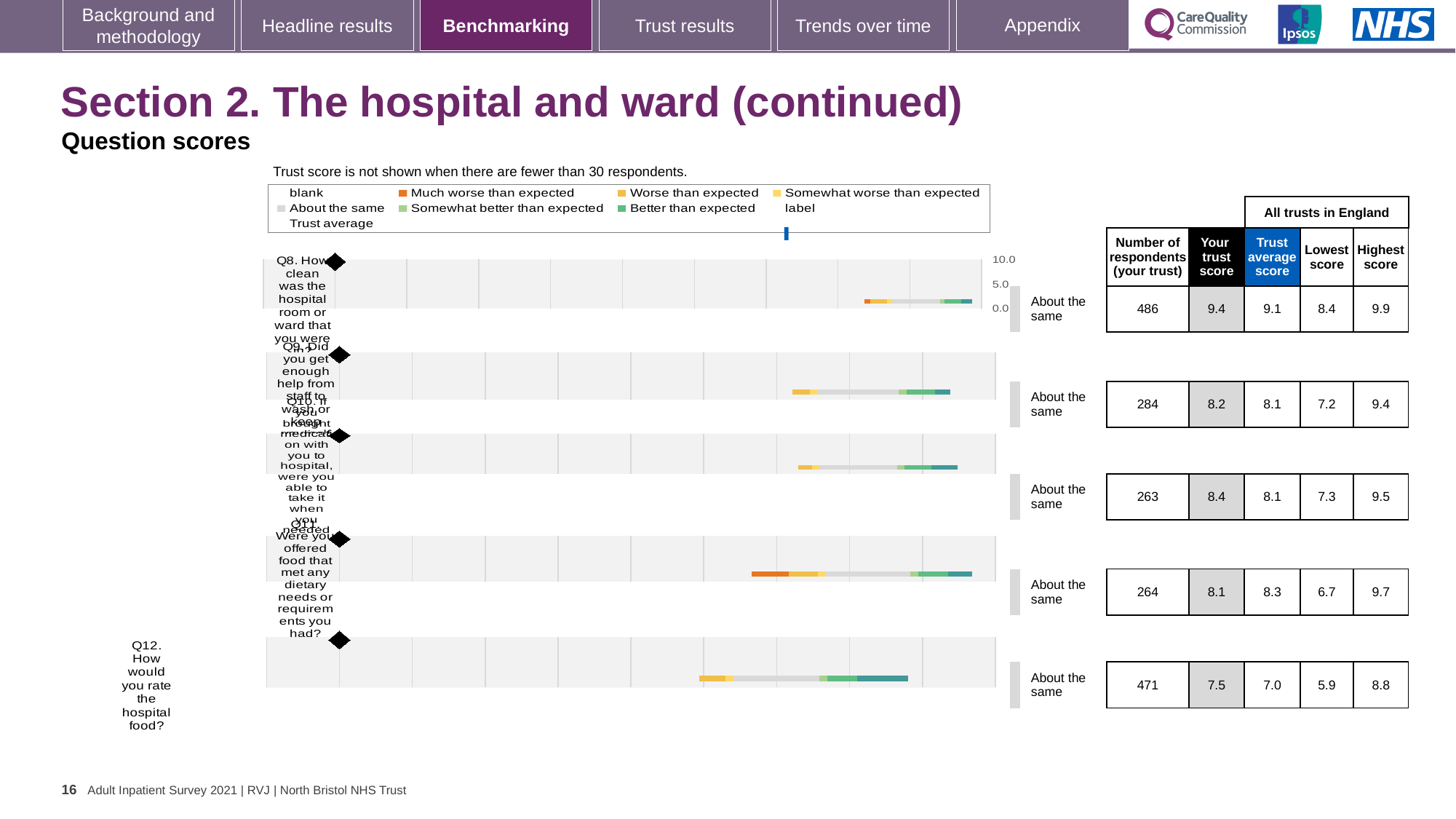
How many questions (Q8 to Q12) are plotted on the chart? 5 What is the 'Your trust score' for Q8 (How clean was the hospital room or ward)? 9.4 For Q8, what is the difference between 'Your trust score' and the 'Trust average score'? 0.3 Which question has the lowest 'Your trust score'? Q12 What benchmark category is shown next to Q9 (Did you get enough help from staff to wash or keep yourself clean)? About the same For Q12, what is the difference between the 'Highest score' and the 'Lowest score'? 2.9 How many respondents answered Q12 (How would you rate the hospital food)? 471 What is the 'Highest score' across all trusts in England for Q10? 9.5 Which legend entry is shown in orange? Much worse than expected Which question has the highest 'Your trust score'? Q8 For Q11, which is larger: 'Your trust score' or the 'Trust average score'? Trust average score What kind of chart is used to show the question scores on this slide? bar chart